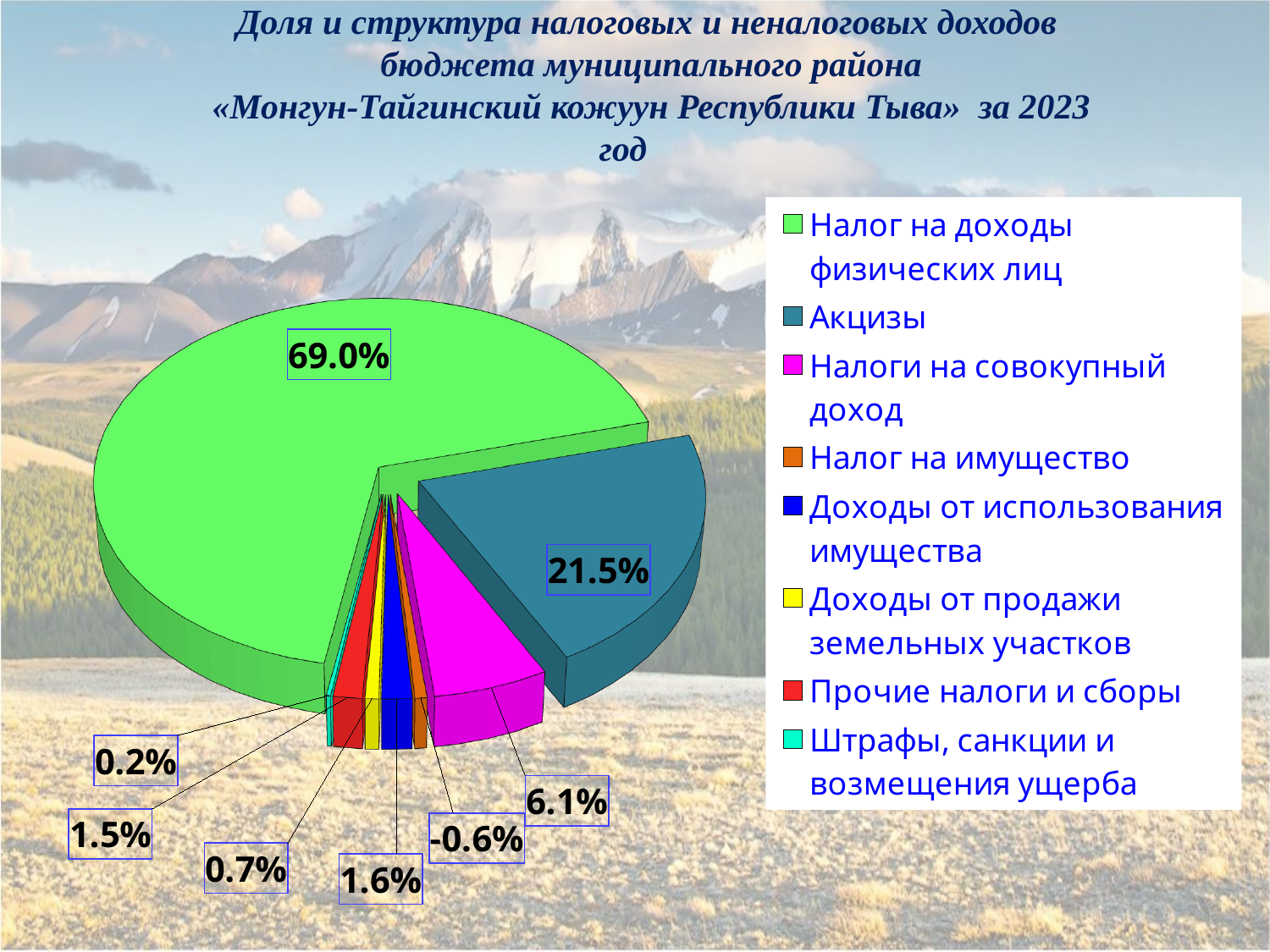
What share of the pie is labelled for Штрафы, санкции и возмещения ущерба? 0.2% Which category has the largest share of the pie? Налог на доходы физических лиц Which is larger: the share for Прочие налоги и сборы or the share for Доходы от продажи земельных участков? Прочие налоги и сборы What share of the pie is labelled for Налог на доходы физических лиц? 69.0% What share of the pie is labelled for Налоги на совокупный доход? 6.1% What kind of chart is shown on the slide? pie chart What is the difference between the shares for Налог на доходы физических лиц and Акцизы? 47.5% What share of the pie is labelled for Акцизы? 21.5% What share of the pie is labelled for Доходы от использования имущества? 1.6% How many categories does the legend list? 8 What value is labelled for Налог на имущество? -0.6% Which category has the smallest labelled value in the pie? Налог на имущество